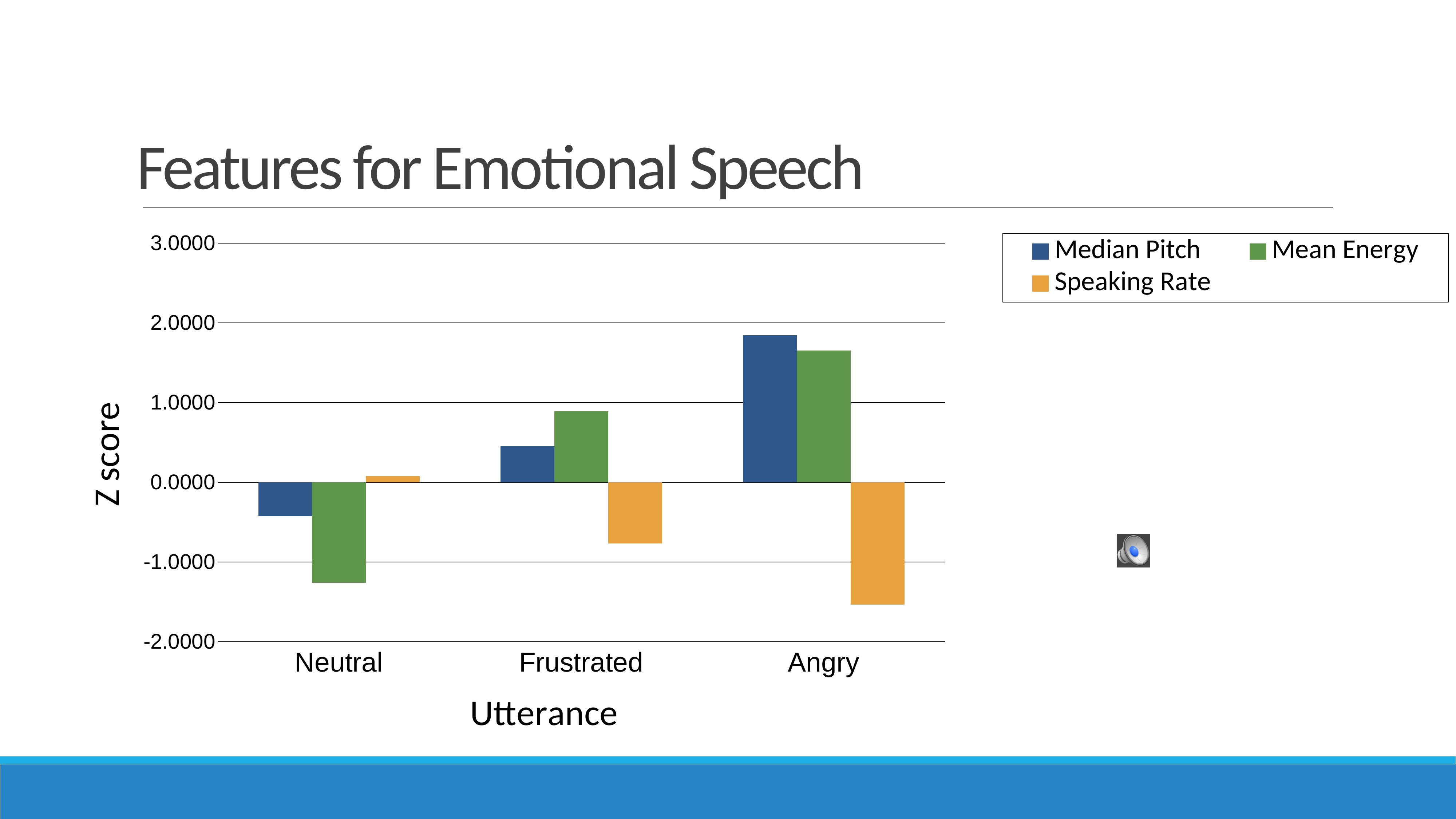
How many utterance categories are shown on the x axis? 3 For Frustrated, which is larger: Median Pitch or Mean Energy? Mean Energy What is the label on the y axis? Z score Which utterance category has the lowest Mean Energy z score? Neutral Is the Mean Energy value for Neutral greater or less than -1.0000? less How many series does the legend list? 3 Does the Median Pitch z score rise or fall from Neutral to Frustrated to Angry? rise What kind of chart is shown on the slide? bar chart Which utterance category has the lowest Speaking Rate z score? Angry Is the Median Pitch value for Angry greater or less than 2.0000? less Is the Mean Energy value for Angry greater or less than 1.0000? greater Which utterance category has the highest Median Pitch z score? Angry